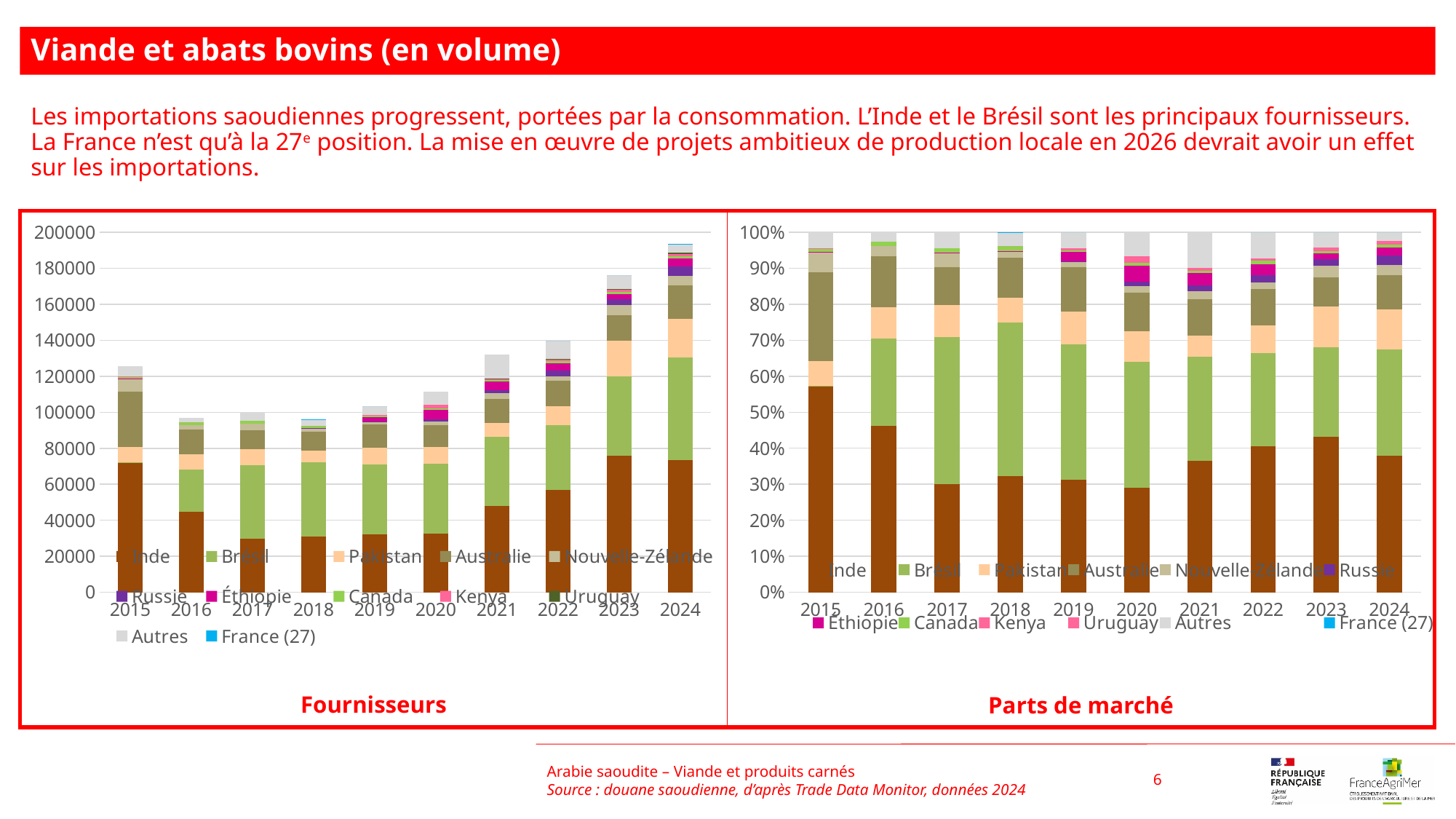
How many years are shown on the x axis of the 'Fournisseurs' chart? 10 In the 'Fournisseurs' chart, is the total for 2021 greater or less than 120000? greater In the 'Parts de marché' chart, is the share of Inde in 2015 greater or less than 50%? greater In the 'Fournisseurs' chart, is the total for 2024 greater or less than 180000? greater In the 'Fournisseurs' chart, which year has the highest total bar? 2024 In the 'Fournisseurs' chart, do the total bars rise or fall from 2020 to 2024? rise How many series does the legend of the 'Fournisseurs' chart list? 12 What is the title of the chart on the right of the slide? Parts de marché What kind of chart is the 'Fournisseurs' chart on the left? stacked bar chart In the 'Fournisseurs' chart, which total is larger, 2019 or 2023? 2023